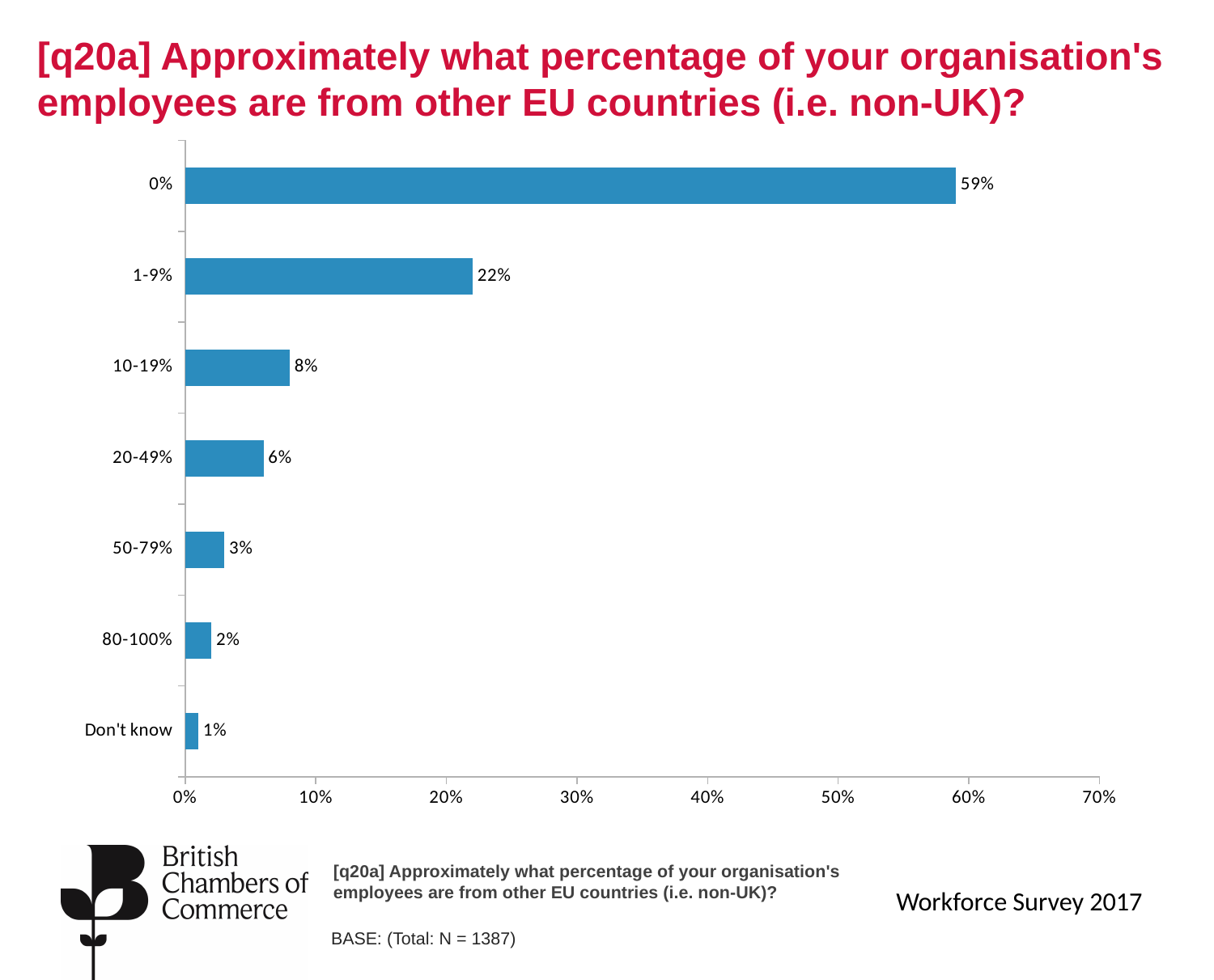
Which is larger, the value for 10-19% or the value for 20-49%? 10-19% What is the value for the Don't know category? 1% Which category has the highest value? 0% Is the value for 1-9% greater or less than 20%? greater What percentage of respondents said 0% of their employees are from other EU countries? 59% What is the value for the 1-9% category? 22% What is the difference between the values for 10-19% and 50-79%? 5% What is the value for the 20-49% category? 6% What kind of chart is shown on the slide? Bar chart Which category has the lowest value? Don't know How many categories are shown on the chart? 7 What is the difference between the values for 0% and 1-9%? 37%